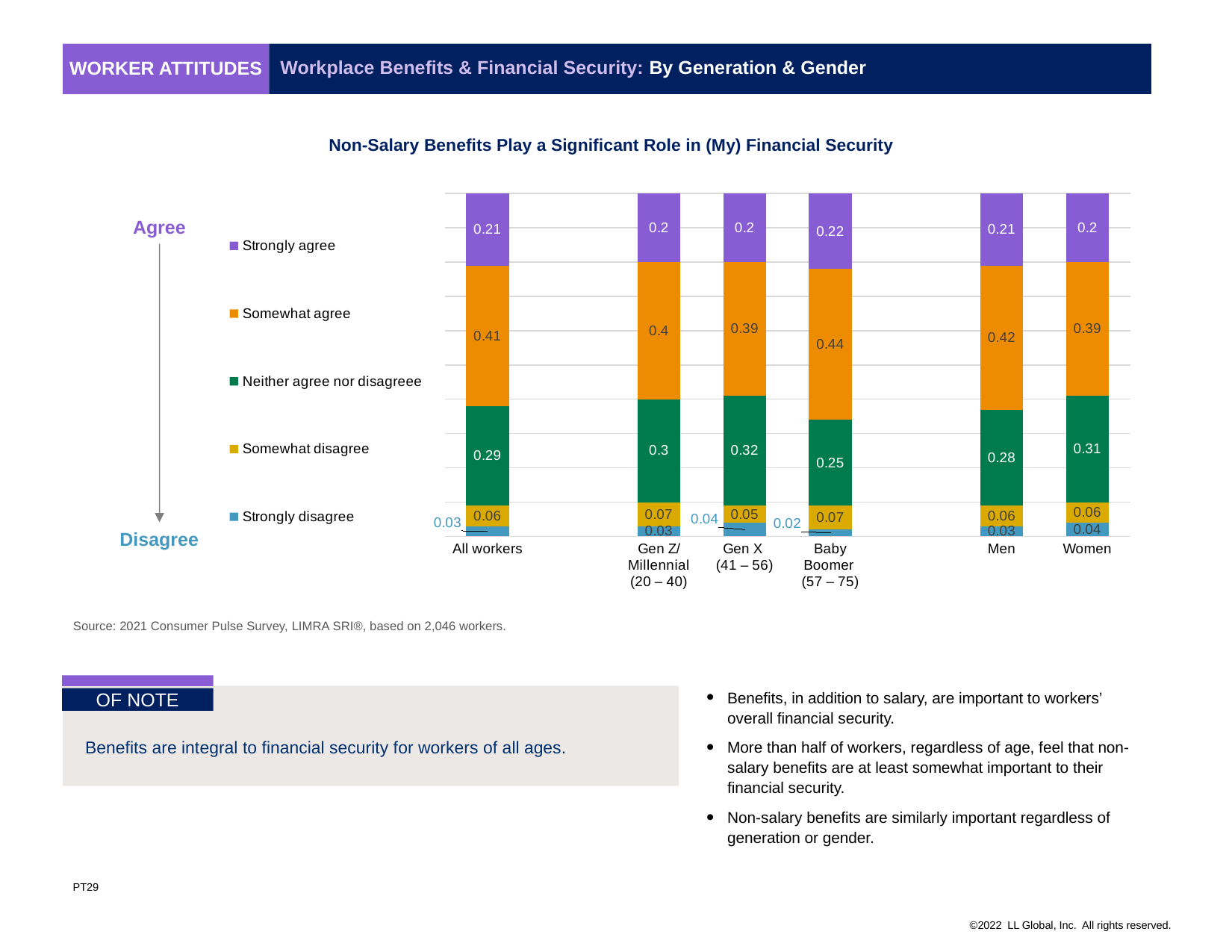
How many series does the legend list? 5 How many categories are shown on the x axis? 6 What is the difference between the Somewhat agree values for Baby Boomer (57 – 75) and Women? 0.05 What is the Neither agree nor disagree value for Gen X (41 – 56)? 0.32 What kind of chart is shown on the slide? Stacked bar chart Which category has the lowest Neither agree nor disagree value? Baby Boomer (57 – 75) Which category has the highest Somewhat agree value? Baby Boomer (57 – 75) What is the Strongly disagree value for Women? 0.04 What is the title of the chart? Non-Salary Benefits Play a Significant Role in (My) Financial Security What is the Strongly agree value for All workers? 0.21 Which is larger, the Neither agree nor disagree value for Men or for Women? Women What is the Somewhat agree value for Baby Boomer (57 – 75)? 0.44